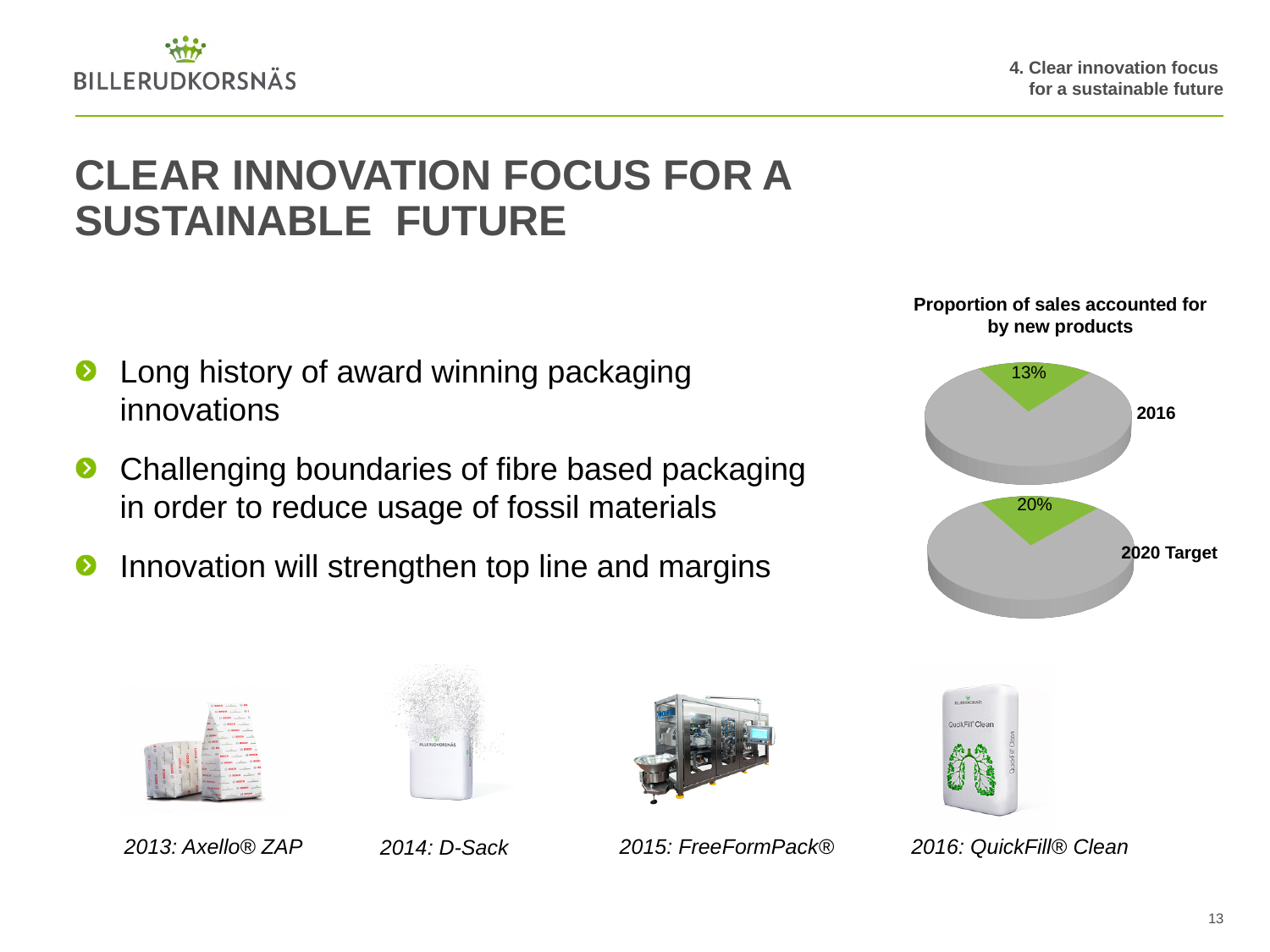
What is the title of the pie charts on the right side of the slide? Proportion of sales accounted for by new products How many pie charts are shown under the title 'Proportion of sales accounted for by new products'? 2 In the 'Proportion of sales accounted for by new products' charts, what is the 2020 Target share of sales from new products? 20% In the 'Proportion of sales accounted for by new products' charts, what colour is the slice representing new products? Green In the 'Proportion of sales accounted for by new products' charts, by how many percentage points does the 2020 Target exceed the 2016 share? 7 percentage points In the 'Proportion of sales accounted for by new products' charts, what share of sales did new products account for in 2016? 13% In the 'Proportion of sales accounted for by new products' charts, which is larger: the 2016 share or the 2020 Target share? 2020 Target In the 'Proportion of sales accounted for by new products' charts, is the 2016 share of sales from new products greater or less than 20%? less What type of charts are used to show the proportion of sales accounted for by new products? Pie charts In the 'Proportion of sales accounted for by new products' charts, does the share of sales from new products rise or fall from 2016 to the 2020 Target? rise In the 'Proportion of sales accounted for by new products' charts, which pie has the smaller new-products slice? 2016